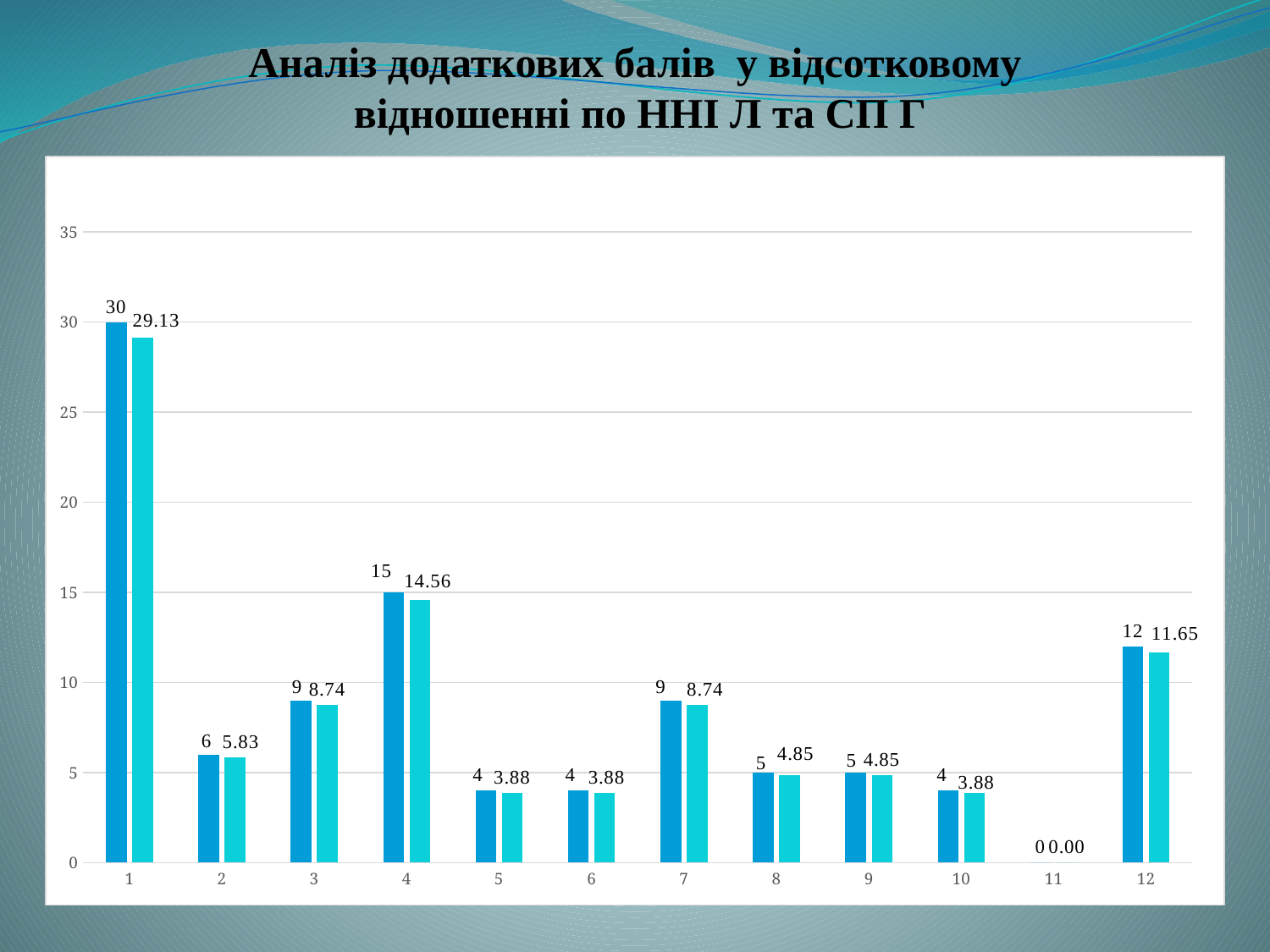
What is the difference between the dark blue bar values for category 1 and category 4? 15 What is the value of the dark blue bar for category 1? 30 How many categories are shown on the x axis? 12 Which category has the highest dark blue bar? 1 What is the value of the light cyan bar for category 4? 14.56 Is the light cyan bar for category 1 greater or less than 25? greater What is the value of the light cyan bar for category 12? 11.65 What is the value of the light cyan bar for category 11? 0.00 What is the difference between the light cyan bar values for category 3 and category 2? 2.91 What type of chart is shown on the slide? bar chart Which category has the lowest light cyan bar? 11 Which is larger: the dark blue bar for category 12 or the dark blue bar for category 7? category 12